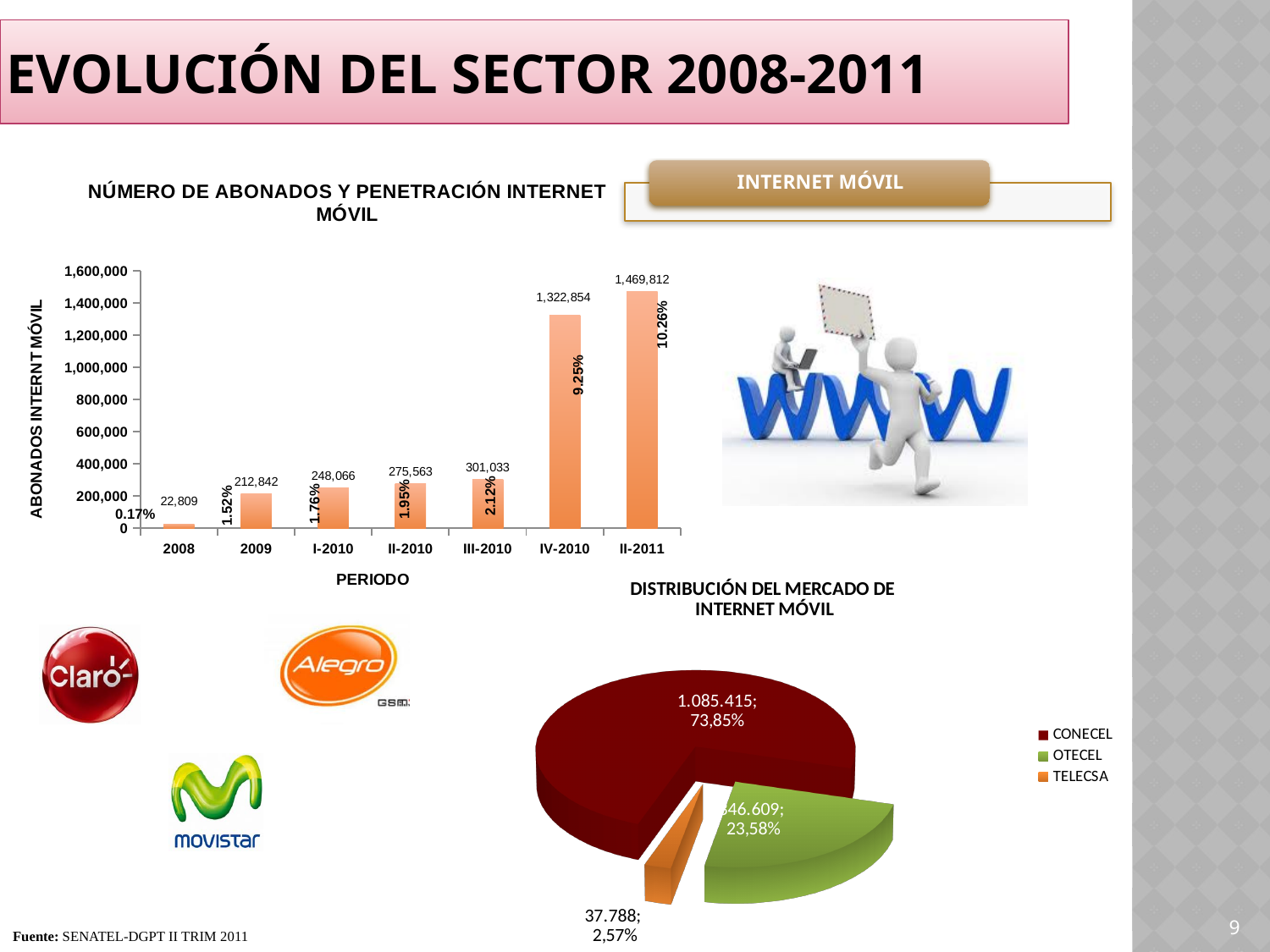
In the bar chart 'NÚMERO DE ABONADOS Y PENETRACIÓN INTERNET MÓVIL', what is the difference in subscribers between II-2011 and IV-2010? 146,958 In the bar chart 'NÚMERO DE ABONADOS Y PENETRACIÓN INTERNET MÓVIL', what penetration percentage is shown for II-2011? 10.26% What kind of chart is 'DISTRIBUCIÓN DEL MERCADO DE INTERNET MÓVIL'? pie chart In the bar chart 'NÚMERO DE ABONADOS Y PENETRACIÓN INTERNET MÓVIL', do the subscriber numbers rise or fall from 2008 to II-2011? rise In the bar chart 'NÚMERO DE ABONADOS Y PENETRACIÓN INTERNET MÓVIL', how many periods are shown on the x axis? 7 In the bar chart 'NÚMERO DE ABONADOS Y PENETRACIÓN INTERNET MÓVIL', which period has the highest number of subscribers? II-2011 In the bar chart 'NÚMERO DE ABONADOS Y PENETRACIÓN INTERNET MÓVIL', what is the number of subscribers for IV-2010? 1,322,854 In the pie chart 'DISTRIBUCIÓN DEL MERCADO DE INTERNET MÓVIL', what share of the market does CONECEL hold? 73,85% In the bar chart 'NÚMERO DE ABONADOS Y PENETRACIÓN INTERNET MÓVIL', which period has the lowest number of subscribers? 2008 In the pie chart 'DISTRIBUCIÓN DEL MERCADO DE INTERNET MÓVIL', what is the value shown for TELECSA? 37.788 In the bar chart 'NÚMERO DE ABONADOS Y PENETRACIÓN INTERNET MÓVIL', what is the number of subscribers for 2008? 22,809 How many entries does the legend of the pie chart 'DISTRIBUCIÓN DEL MERCADO DE INTERNET MÓVIL' list? 3